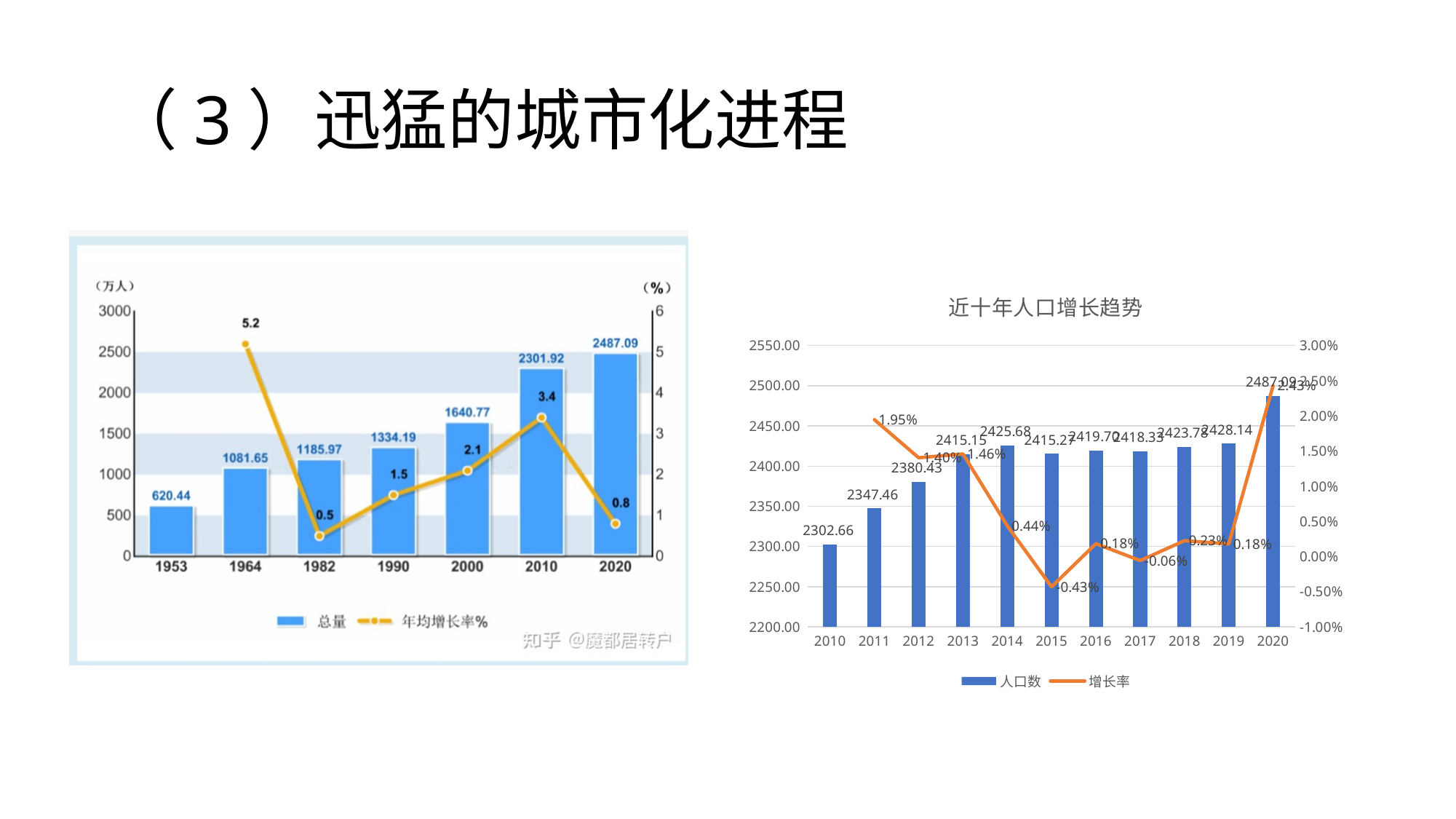
In the left chart, what is the 总量 value for 1953? 620.44 In the left chart, which year has the lowest 年均增长率% value? 1982 In the chart titled 近十年人口增长趋势, which year has the highest 增长率 value? 2020 In the left chart, what is the 年均增长率% value shown for 1964? 5.2 In the left chart, how many years are shown on the x axis? 7 In the chart titled 近十年人口增长趋势, how many series does the legend list? 2 In the left chart, what is the difference between the 总量 values for 2020 and 2010? 185.17 In the chart titled 近十年人口增长趋势, what is the 增长率 value for 2015? -0.43% In the chart titled 近十年人口增长趋势, what is the difference between the 人口数 values for 2011 and 2010? 44.80 In the chart titled 近十年人口增长趋势, what is the 人口数 value for 2014? 2425.68 In the chart titled 近十年人口增长趋势, which is larger, the 人口数 value for 2013 or for 2015? 2015 In the left chart, is the 总量 value for 2000 greater or less than 1500? greater